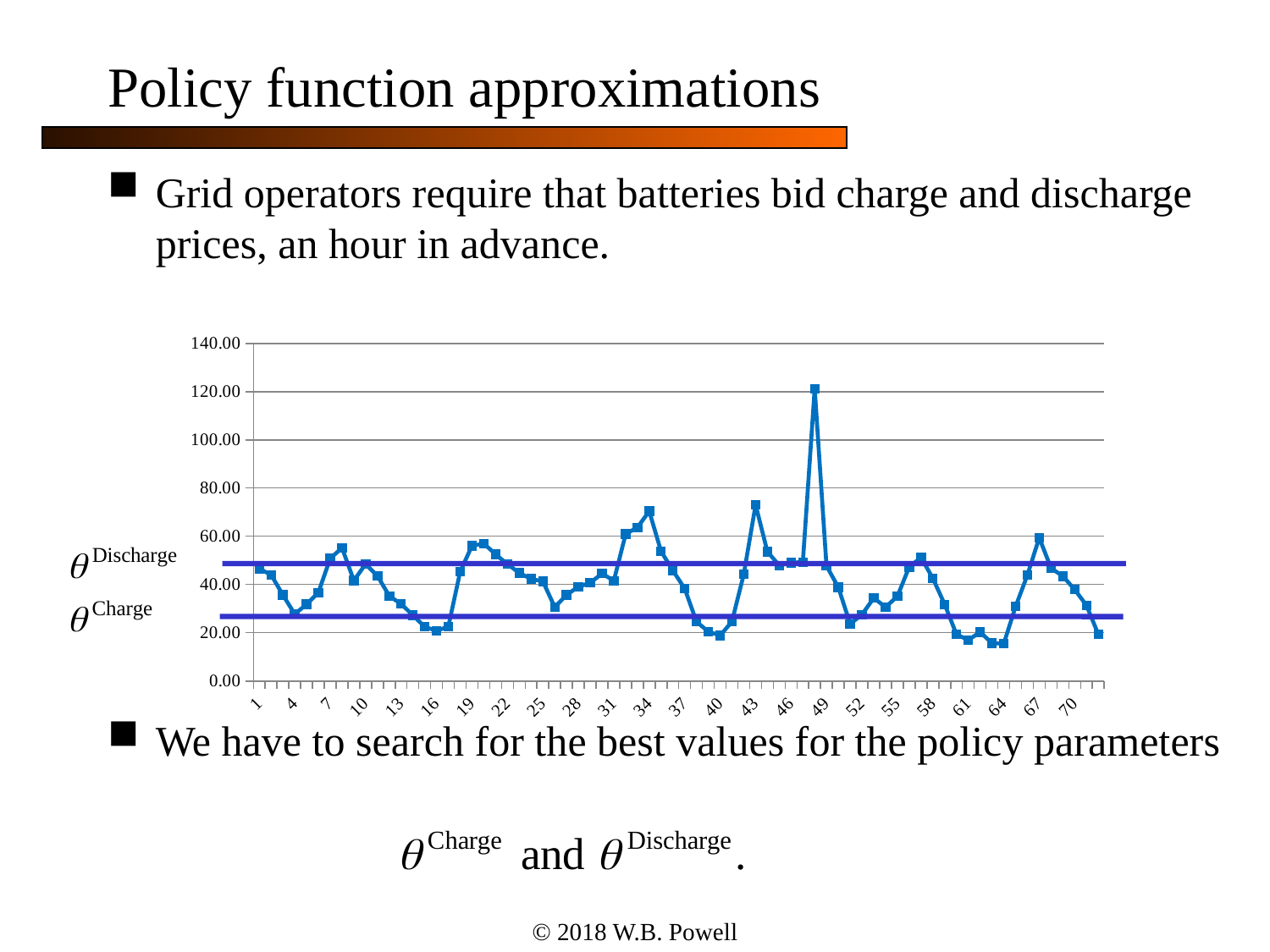
Is the value of the plotted line at x = 34 greater or less than 60? greater Is the peak value of the plotted line near x = 48 greater or less than 100? greater At which x-axis position does the plotted line reach its highest value? 48 Is the value of the plotted line at x = 40 greater or less than 40? less Which horizontal line is higher on the chart, θ^Discharge or θ^Charge? θ^Discharge What is the highest value shown on the y axis? 140.00 What kind of chart is shown on the slide? line chart Which is larger, the plotted value at x = 16 or at x = 34? x = 34